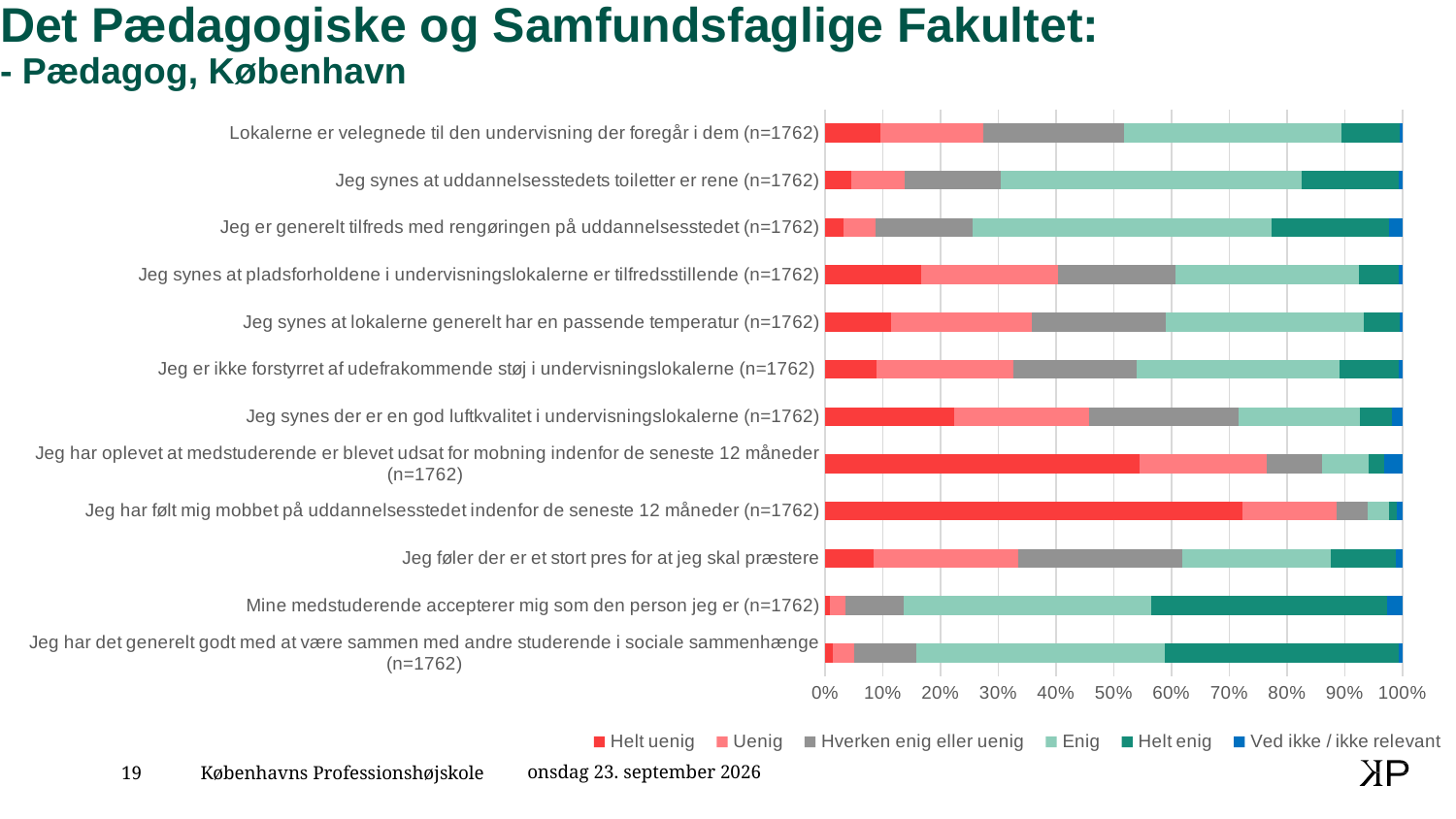
How many series does the chart legend list? 6 How many statements (categories) are plotted in the chart? 12 Is the 'Helt uenig' share for 'Jeg har følt mig mobbet på uddannelsesstedet indenfor de seneste 12 måneder' greater or less than 60%? greater What is the last entry in the chart legend? Ved ikke / ikke relevant Is the 'Helt uenig' share for 'Mine medstuderende accepterer mig som den person jeg er' greater or less than 10%? less What is the first entry in the chart legend? Helt uenig Is the 'Helt uenig' share for 'Jeg har oplevet at medstuderende er blevet udsat for mobning indenfor de seneste 12 måneder' greater or less than 50%? greater What kind of chart is shown on the slide? Stacked bar chart Which has the larger 'Helt uenig' share: 'Jeg synes at pladsforholdene i undervisningslokalerne er tilfredsstillende' or 'Jeg synes at uddannelsesstedets toiletter er rene'? Jeg synes at pladsforholdene i undervisningslokalerne er tilfredsstillende Which has the larger 'Helt uenig' share: 'Jeg har følt mig mobbet på uddannelsesstedet indenfor de seneste 12 måneder' or 'Jeg har oplevet at medstuderende er blevet udsat for mobning indenfor de seneste 12 måneder'? Jeg har følt mig mobbet på uddannelsesstedet indenfor de seneste 12 måneder Which statement has the largest 'Helt uenig' share? Jeg har følt mig mobbet på uddannelsesstedet indenfor de seneste 12 måneder (n=1762)